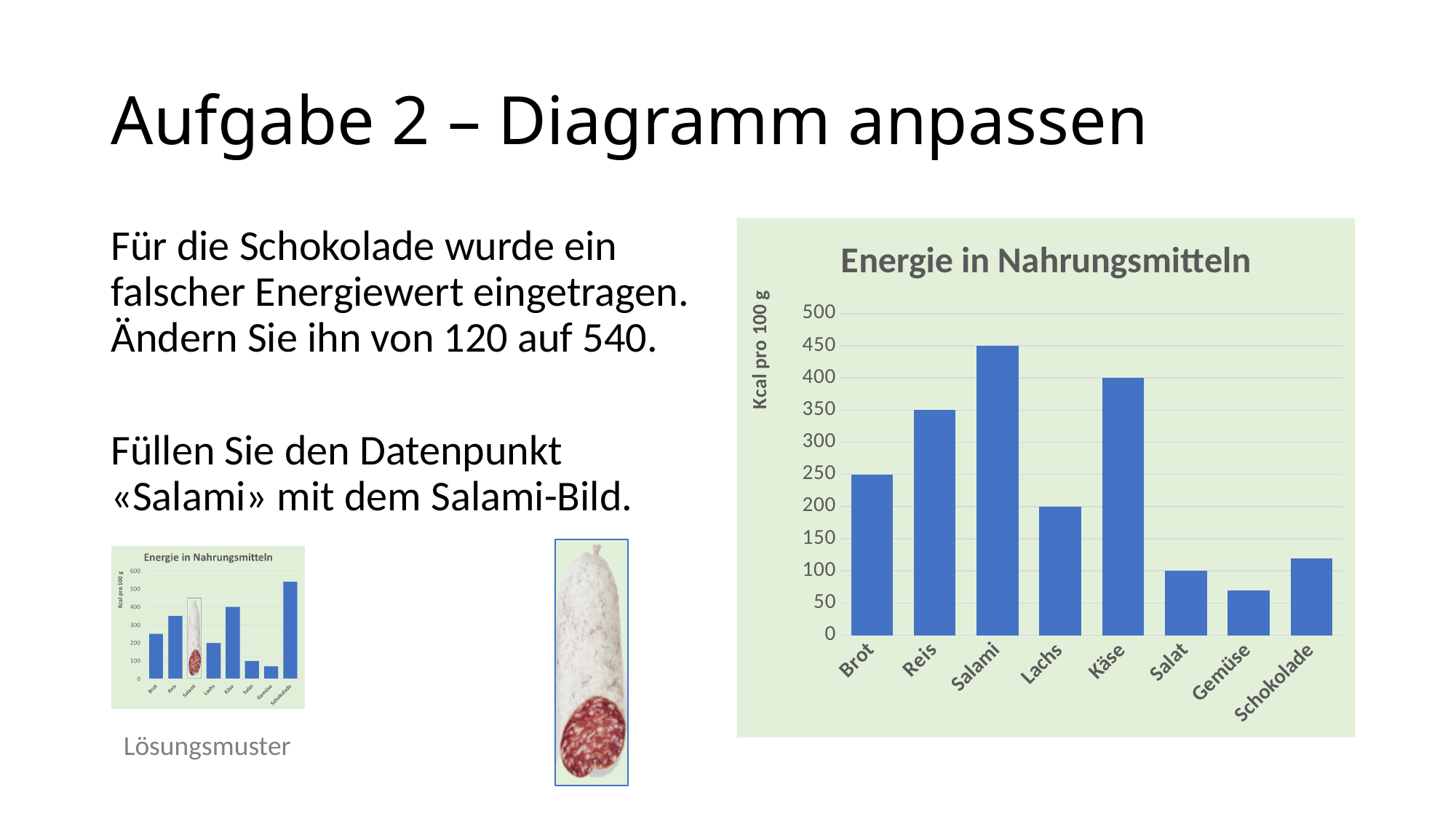
In the large chart 'Energie in Nahrungsmitteln', what is the difference between the values for Salami and Lachs? 250 In the large chart 'Energie in Nahrungsmitteln', is the value for Schokolade greater or less than 100? greater In the large chart 'Energie in Nahrungsmitteln', which category has the lowest value? Gemüse What is the y-axis title of the large chart 'Energie in Nahrungsmitteln'? Kcal pro 100 g In the large chart 'Energie in Nahrungsmitteln', which category has the highest value? Salami In the large chart 'Energie in Nahrungsmitteln', which is larger, the value for Reis or the value for Käse? Käse In the large chart 'Energie in Nahrungsmitteln', what is the value for Brot? 250 How many categories are shown in the large chart 'Energie in Nahrungsmitteln'? 8 In the large chart 'Energie in Nahrungsmitteln', what is the value for Käse? 400 What kind of chart is the large chart 'Energie in Nahrungsmitteln'? bar chart In the large chart 'Energie in Nahrungsmitteln', what is the value for Salami? 450 In the large chart 'Energie in Nahrungsmitteln', is the value for Gemüse greater or less than 100? less